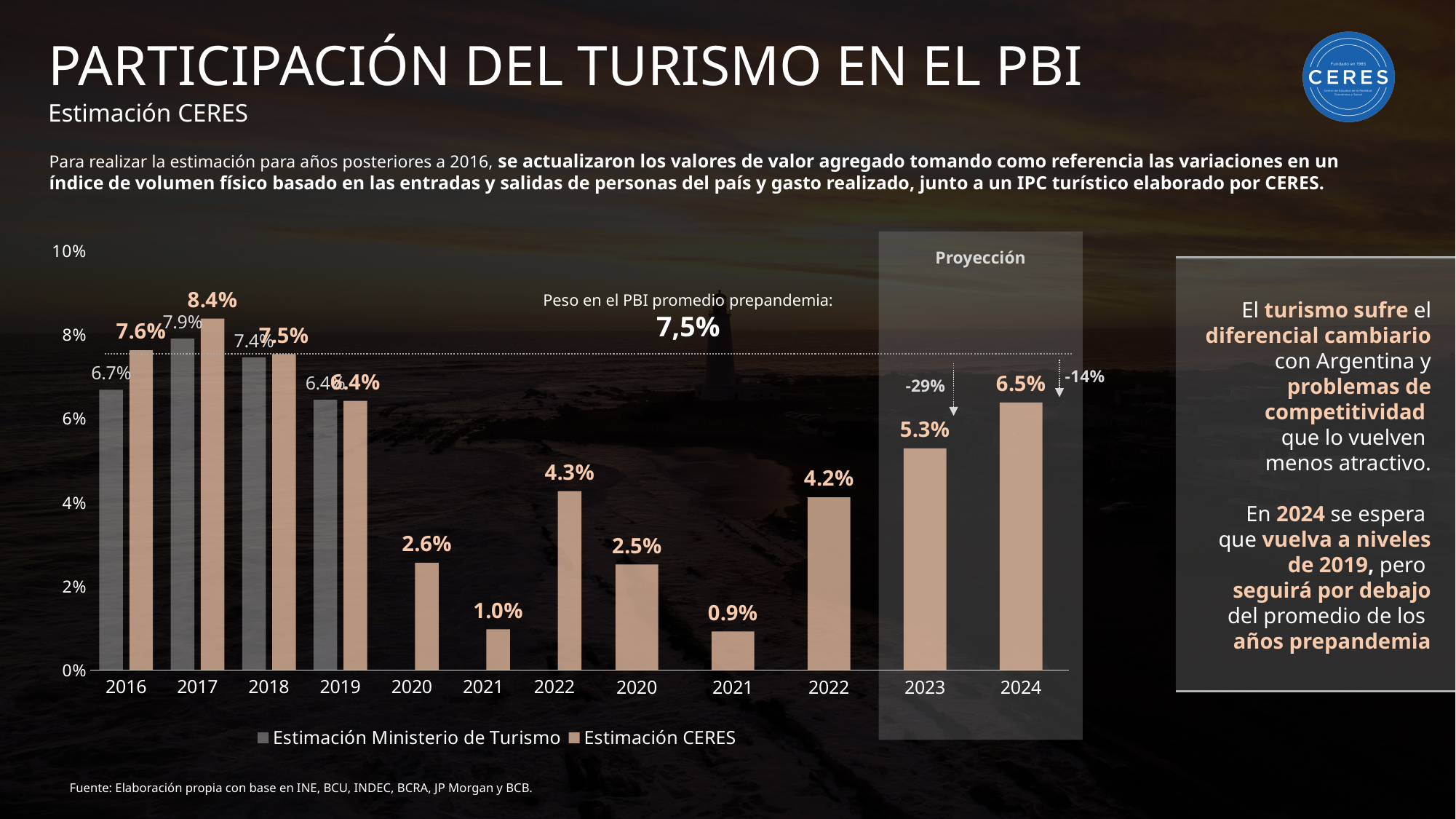
What value is given for the pre-pandemic average share of GDP (Peso en el PBI promedio prepandemia)? 7,5% How much higher is the Estimación CERES value for 2024 than for 2023? 1.2 percentage points What is the Estimación Ministerio de Turismo value for 2016? 6.7% What is the projected Estimación CERES value for 2023? 5.3% What is the projected Estimación CERES value for 2024? 6.5% How many series does the legend list? 2 What is the Estimación CERES value for 2017? 8.4% What is the lowest value labelled on any bar in the chart? 0.9% By how many percentage points does the Estimación CERES value for 2016 exceed the Estimación Ministerio de Turismo value for 2016? 0.9 percentage points What kind of chart is shown on the slide? Bar chart In which year does the Estimación CERES series reach its highest value? 2017 For 2017, which is larger: the Estimación Ministerio de Turismo value or the Estimación CERES value? Estimación CERES